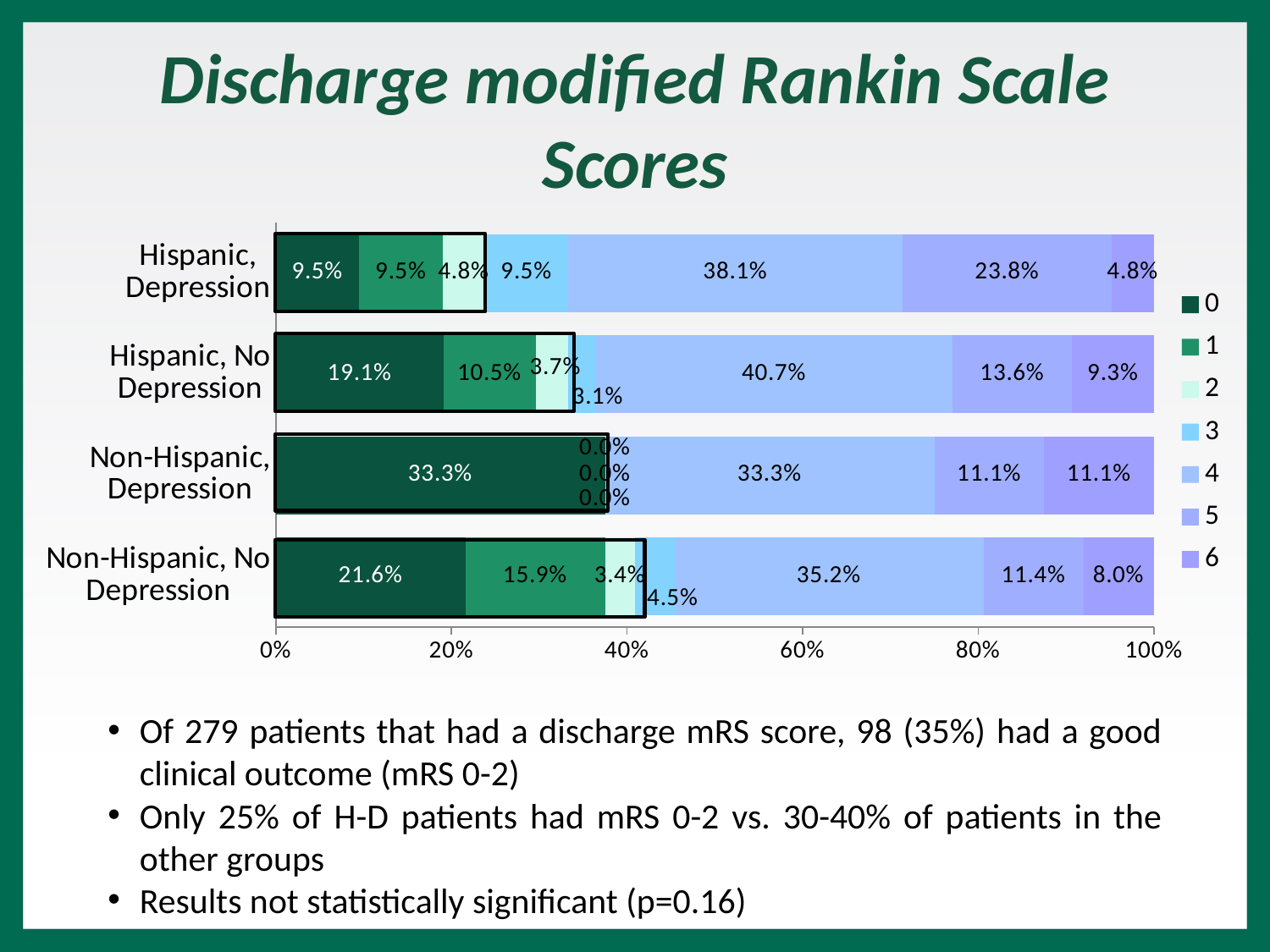
What percentage of the Hispanic, No Depression group had an mRS score of 0? 19.1% What percentage of the Non-Hispanic, No Depression group had an mRS score of 1? 15.9% What kind of chart is shown on the slide? stacked bar chart What is the title of the chart on the slide? Discharge modified Rankin Scale Scores What percentage of the Hispanic, Depression group had an mRS score of 4? 38.1% Which group has the highest percentage with an mRS score of 0? Non-Hispanic, Depression How many series does the legend list? 7 How many patient groups (categories) are shown on the chart? 4 What percentage of the Non-Hispanic, Depression group had an mRS score of 6? 11.1% What is the difference between the mRS 4 percentages of the Hispanic, No Depression group and the Non-Hispanic, No Depression group? 5.5% Which group has the lowest percentage with an mRS score of 0? Hispanic, Depression Which is larger: the mRS 5 percentage for Hispanic, Depression or for Hispanic, No Depression? Hispanic, Depression